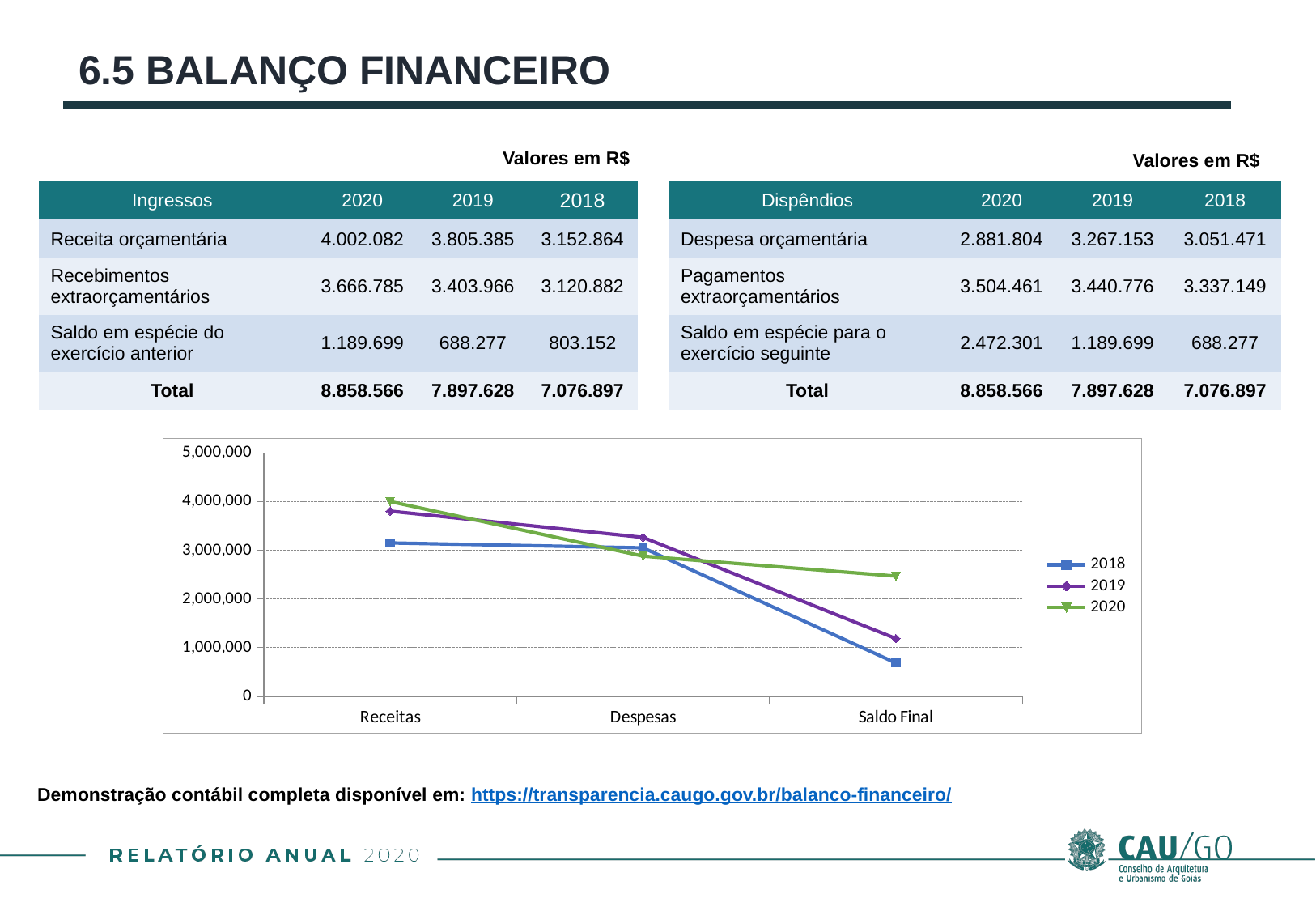
Is the value for Saldo Final in the 2020 series greater or less than 2,000,000? greater Is the value for Saldo Final in the 2018 series greater or less than 1,000,000? less What kind of chart is shown on the slide? line chart Which series has the highest value for Despesas? 2019 Does the 2020 series rise or fall from Receitas to Saldo Final? fall How many series does the chart legend list? 3 Is the value for Receitas in the 2020 series greater or less than 3,000,000? greater How many categories are shown along the x axis of the chart? 3 Which series has the highest value for Receitas? 2020 Which series has the highest value for Saldo Final? 2020 Which series has the lowest value for Saldo Final? 2018 What are the entries listed in the chart legend? 2018, 2019, 2020